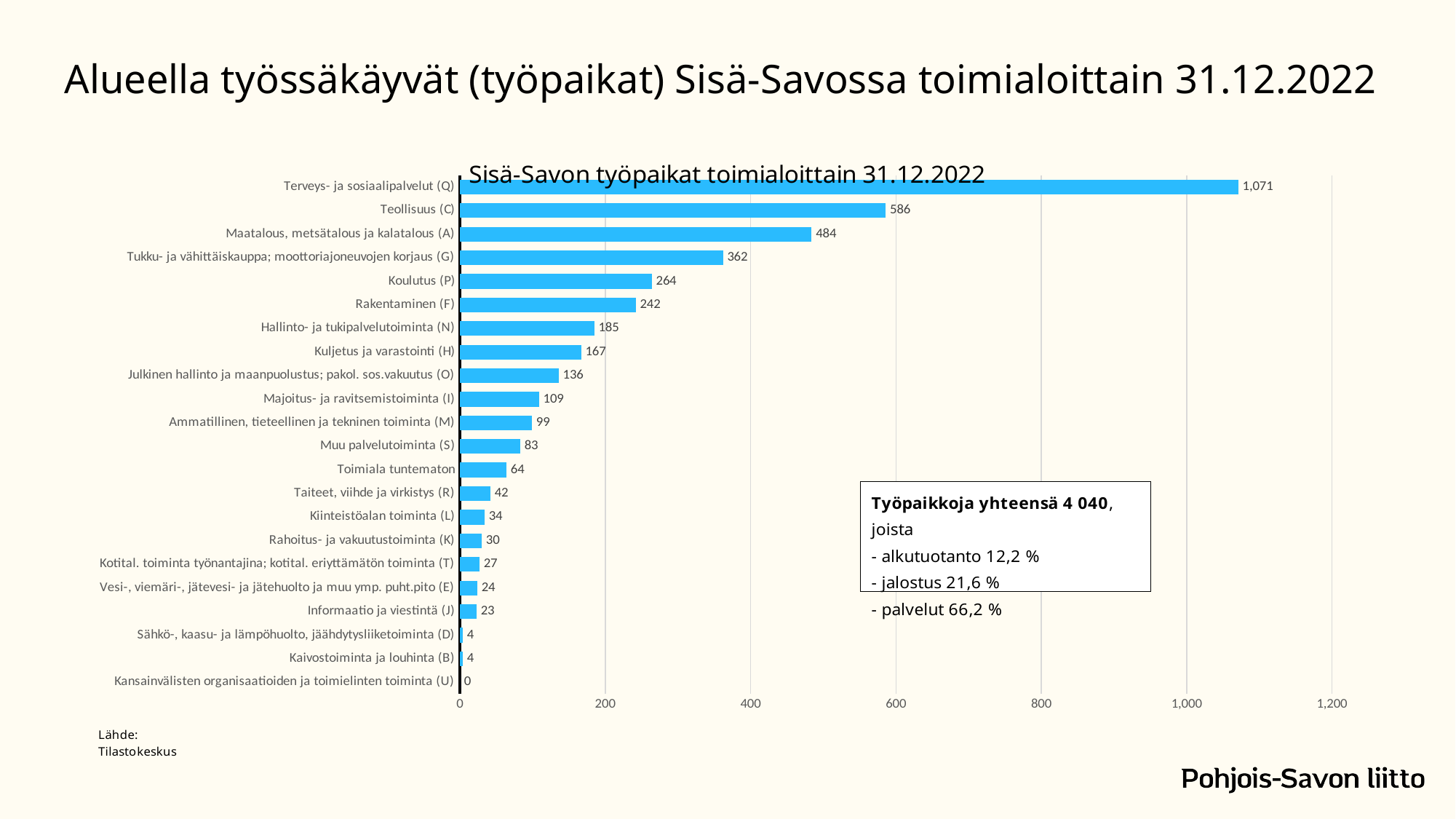
Which is larger, the value for Rakentaminen (F) or the value for Hallinto- ja tukipalvelutoiminta (N)? Rakentaminen (F) Which category has the lowest value? Kansainvälisten organisaatioiden ja toimielinten toiminta (U) Which category has the highest value? Terveys- ja sosiaalipalvelut (Q) What is the value for Informaatio ja viestintä (J)? 23 Is the value for Tukku- ja vähittäiskauppa; moottoriajoneuvojen korjaus (G) greater or less than 400? less What kind of chart is shown on the slide? bar chart How many categories are shown in the chart? 22 What is the difference between the values for Teollisuus (C) and Maatalous, metsätalous ja kalatalous (A)? 102 What is the value for Kuljetus ja varastointi (H)? 167 What is the value for Teollisuus (C)? 586 What is the title of the chart? Sisä-Savon työpaikat toimialoittain 31.12.2022 What is the value for Koulutus (P)? 264